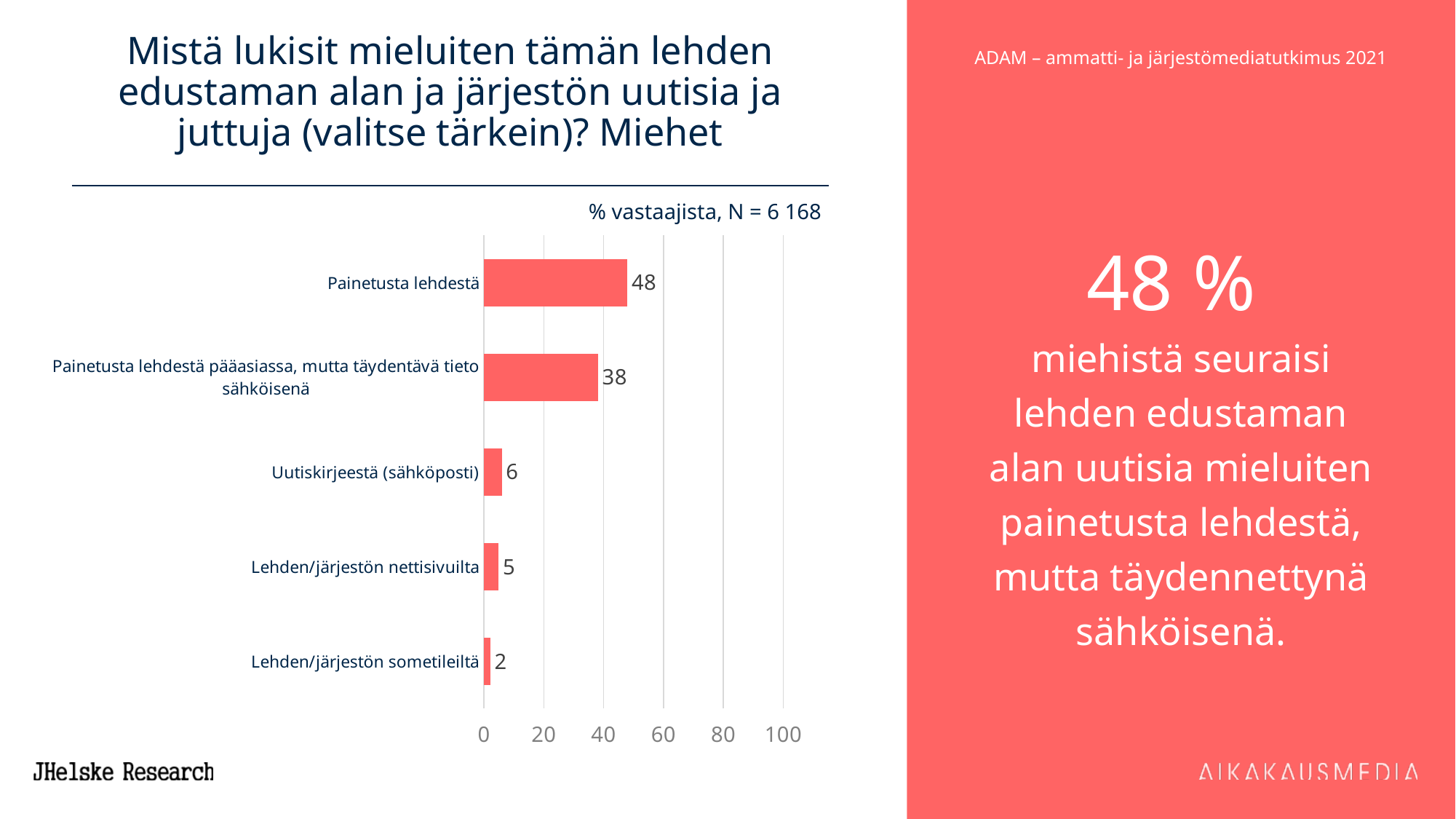
What is the value for "Lehden/järjestön sometileiltä"? 2 Which is larger: the value for "Uutiskirjeestä (sähköposti)" or for "Lehden/järjestön nettisivuilta"? Uutiskirjeestä (sähköposti) Is the value for "Painetusta lehdestä pääasiassa, mutta täydentävä tieto sähköisenä" greater or less than 40? less What is the value for "Uutiskirjeestä (sähköposti)"? 6 Which category has the lowest value? Lehden/järjestön sometileiltä What is the value for "Painetusta lehdestä"? 48 How many categories are shown in the chart? 5 What is the value for "Lehden/järjestön nettisivuilta"? 5 Which category has the highest value? Painetusta lehdestä What is the difference between the values for "Painetusta lehdestä" and "Painetusta lehdestä pääasiassa, mutta täydentävä tieto sähköisenä"? 10 What is the N (number of respondents) stated above the chart? 6 168 What kind of chart is shown on the slide? bar chart